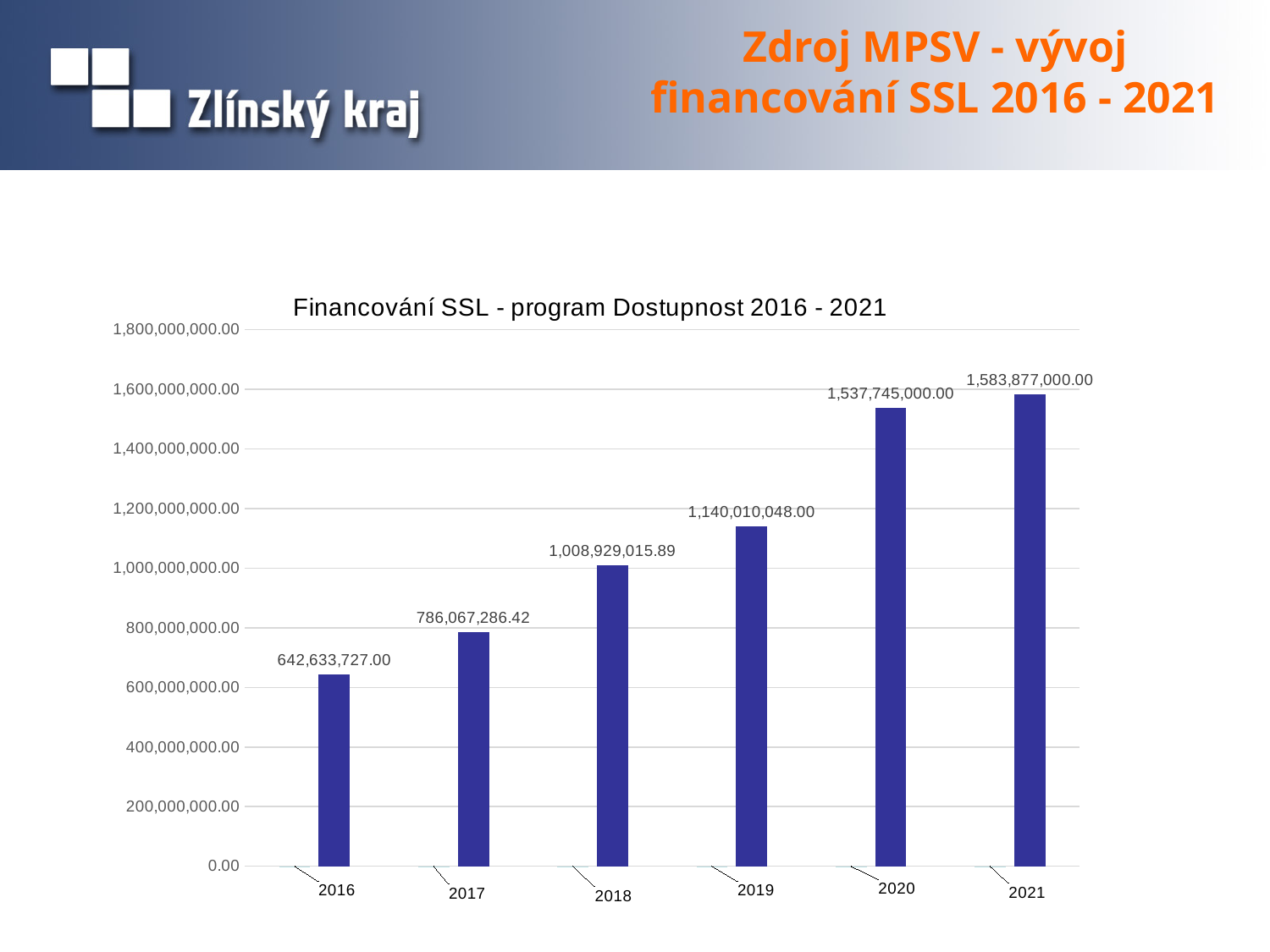
Which is larger, the value for 2019 or the value for 2018? 2019 What is the value for 2020? 1,537,745,000.00 What is the value for 2016? 642,633,727.00 Do the values rise or fall from 2016 to 2021? rise What kind of chart is shown on the slide? bar chart What is the difference between the values for 2017 and 2016? 143,433,559.42 What is the difference between the values for 2021 and 2020? 46,132,000.00 How many years are shown on the x axis? 6 Which year has the lowest value? 2016 What is the value for 2018? 1,008,929,015.89 Is the value for 2019 greater or less than 1,200,000,000.00? less Which year has the highest value? 2021